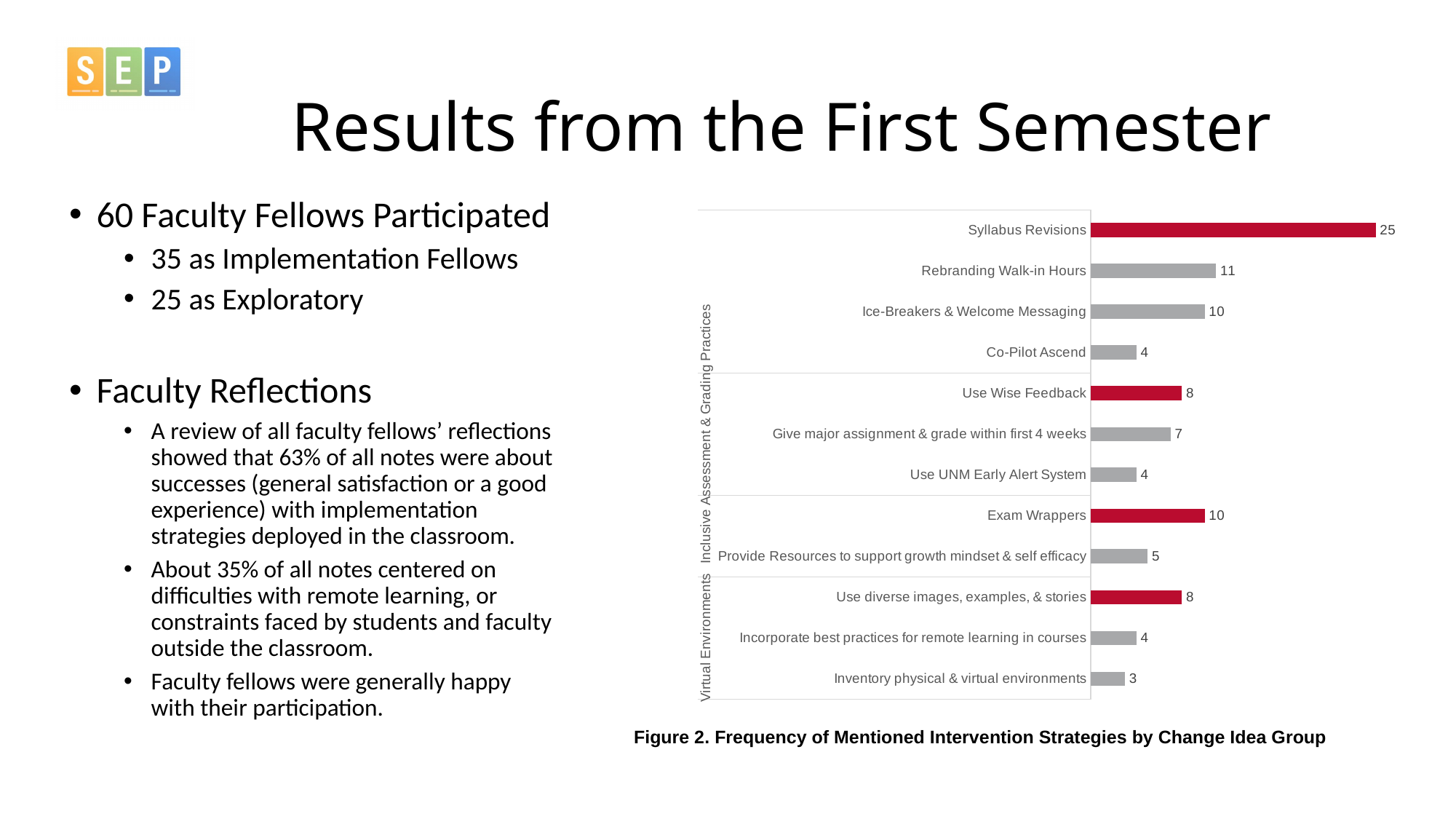
What is the difference between the values for Syllabus Revisions and Rebranding Walk-in Hours? 14 Which has a larger value: Use Wise Feedback or Give major assignment & grade within first 4 weeks? Use Wise Feedback What is the caption of the figure on the slide? Figure 2. Frequency of Mentioned Intervention Strategies by Change Idea Group What value is shown for Inventory physical & virtual environments? 3 What type of chart is shown on the slide? Bar chart Which intervention strategy has the lowest frequency? Inventory physical & virtual environments How many intervention strategies are plotted in the chart? 12 What value is shown for Rebranding Walk-in Hours? 11 What is the difference between the values for Exam Wrappers and Provide Resources to support growth mindset & self efficacy? 5 What value is shown for Exam Wrappers? 10 What value is shown for Syllabus Revisions? 25 Which intervention strategy has the highest frequency? Syllabus Revisions